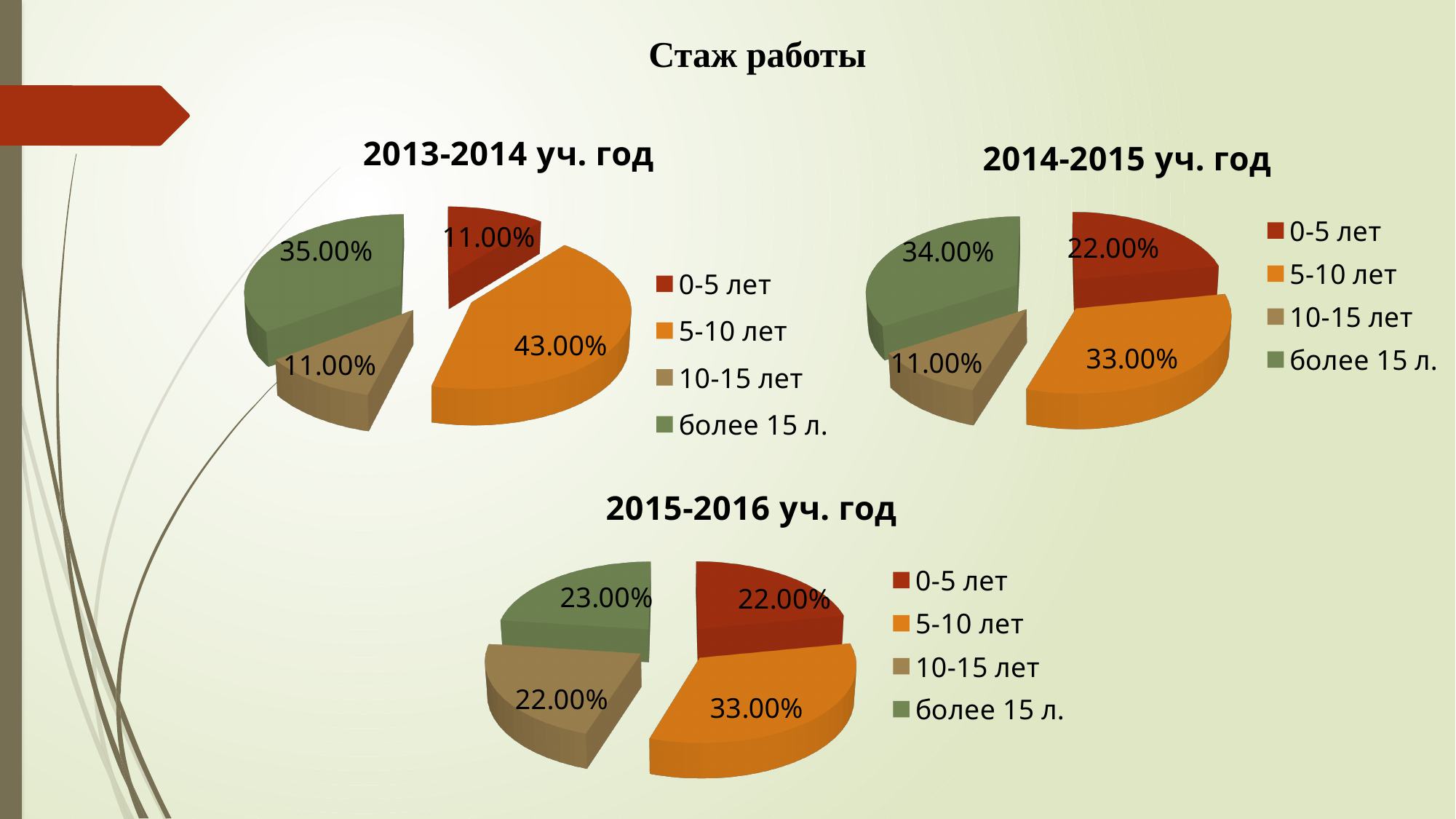
How many series does the legend of the 2015-2016 уч. год chart list? 4 In the 2014-2015 уч. год chart, which category has the smallest share? 10-15 лет What kind of chart is the 2014-2015 уч. год chart? Pie chart In the 2015-2016 уч. год chart, which category has the largest share? 5-10 лет In the 2014-2015 уч. год chart, what is the share for 10-15 лет? 11.00% In the 2015-2016 уч. год chart, what is the share for более 15 л.? 23.00% In the 2014-2015 уч. год chart, which is larger: the share for 0-5 лет or the share for 10-15 лет? 0-5 лет In the 2013-2014 уч. год chart, which category has the largest share? 5-10 лет In the 2013-2014 уч. год chart, what is the share for 5-10 лет? 43.00% In the 2013-2014 уч. год chart, what is the share for более 15 л.? 35.00% In the 2013-2014 уч. год chart, what is the difference between the shares for 5-10 лет and более 15 л.? 8.00% In the 2014-2015 уч. год chart, what is the share for 0-5 лет? 22.00%